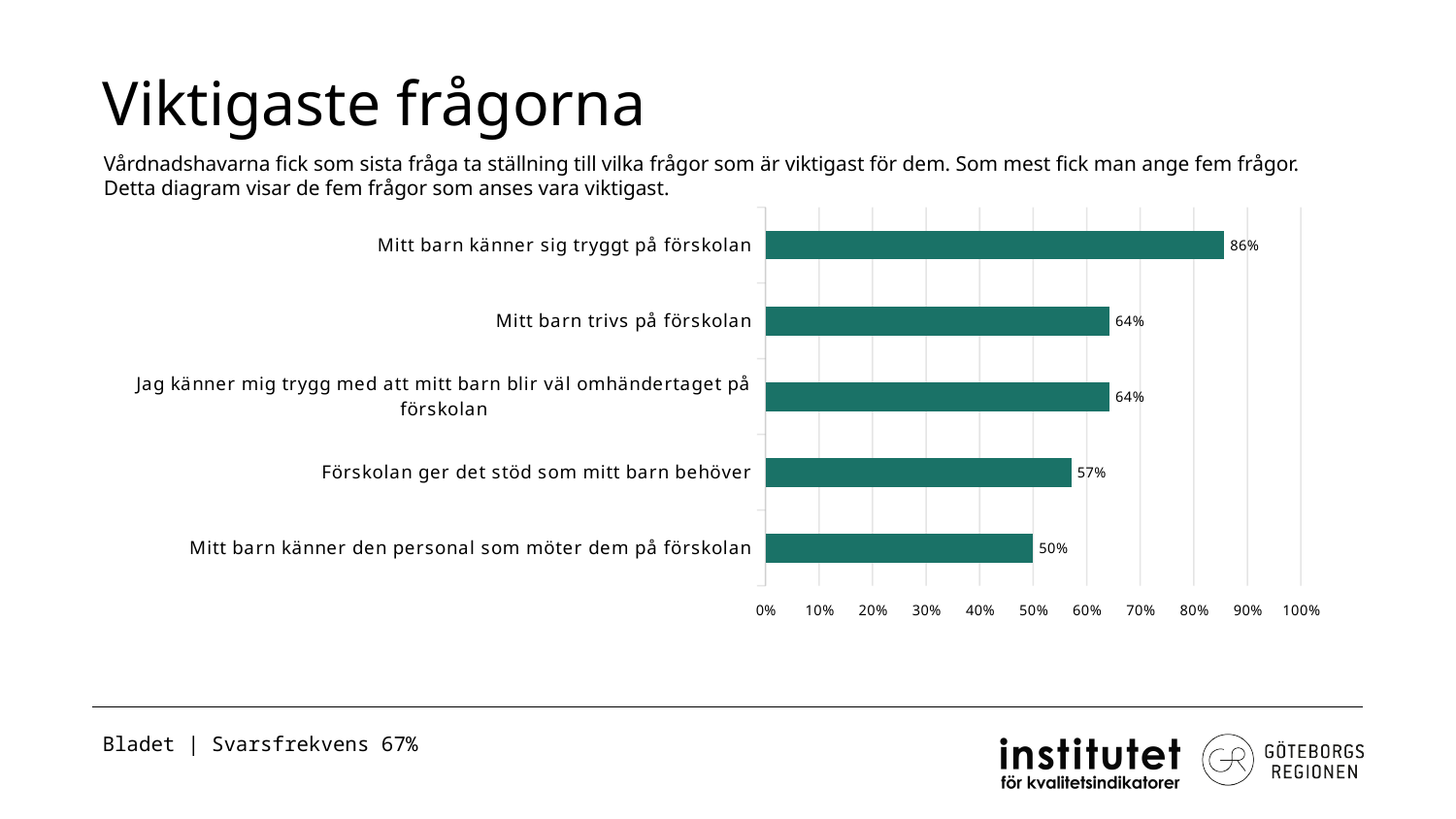
What is the value for "Mitt barn känner sig tryggt på förskolan"? 86% What is the difference between the values for "Mitt barn känner sig tryggt på förskolan" and "Mitt barn trivs på förskolan"? 22% Which category has the lowest value? Mitt barn känner den personal som möter dem på förskolan How many categories are shown in the chart? 5 What kind of chart is shown on the slide? Bar chart Which category has the highest value? Mitt barn känner sig tryggt på förskolan What is the title of the slide containing the chart? Viktigaste frågorna What is the value for "Mitt barn trivs på förskolan"? 64% What is the value for "Mitt barn känner den personal som möter dem på förskolan"? 50% What is the value for "Förskolan ger det stöd som mitt barn behöver"? 57% Which is larger: the value for "Mitt barn trivs på förskolan" or the value for "Förskolan ger det stöd som mitt barn behöver"? Mitt barn trivs på förskolan What is the difference between the values for "Förskolan ger det stöd som mitt barn behöver" and "Mitt barn känner den personal som möter dem på förskolan"? 7%